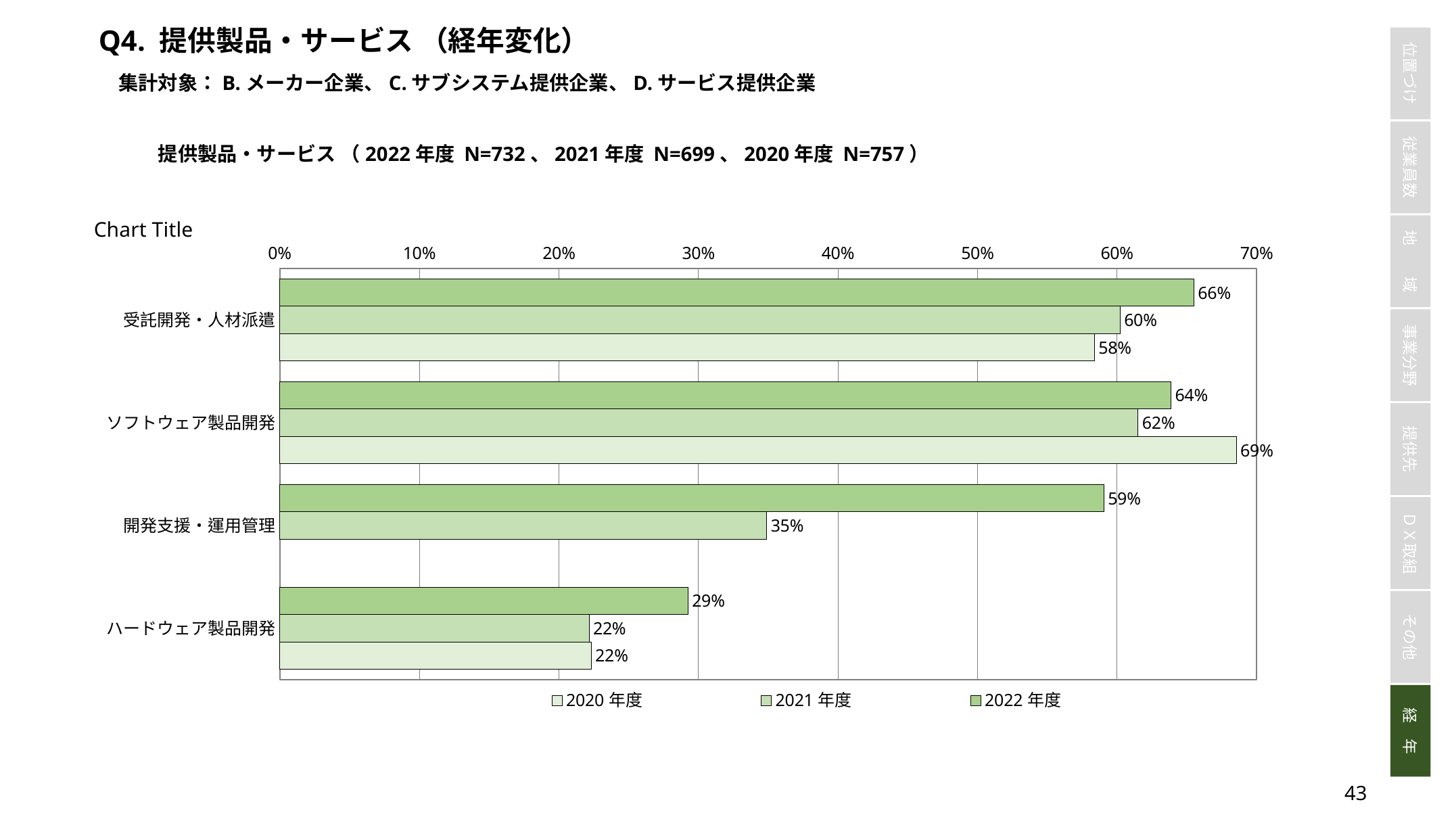
What kind of chart is shown on the slide? Bar chart What is the difference between the 2022 年度 and 2021 年度 values for 開発支援・運用管理? 24% How many series does the legend list? 3 What is the value for 開発支援・運用管理 in the 2021 年度 series? 35% What is the value for ソフトウェア製品開発 in the 2020 年度 series? 69% How many categories are shown on the y axis of the chart? 4 Which category has the highest value in the 2022 年度 series? 受託開発・人材派遣 Which category has the lowest value in the 2021 年度 series? ハードウェア製品開発 For ソフトウェア製品開発, which is larger: the 2020 年度 value or the 2022 年度 value? 2020 年度 What is the value for ハードウェア製品開発 in the 2022 年度 series? 29% What is the value for 受託開発・人材派遣 in the 2022 年度 series? 66% Which series is shown with the darkest green bars according to the legend? 2022 年度